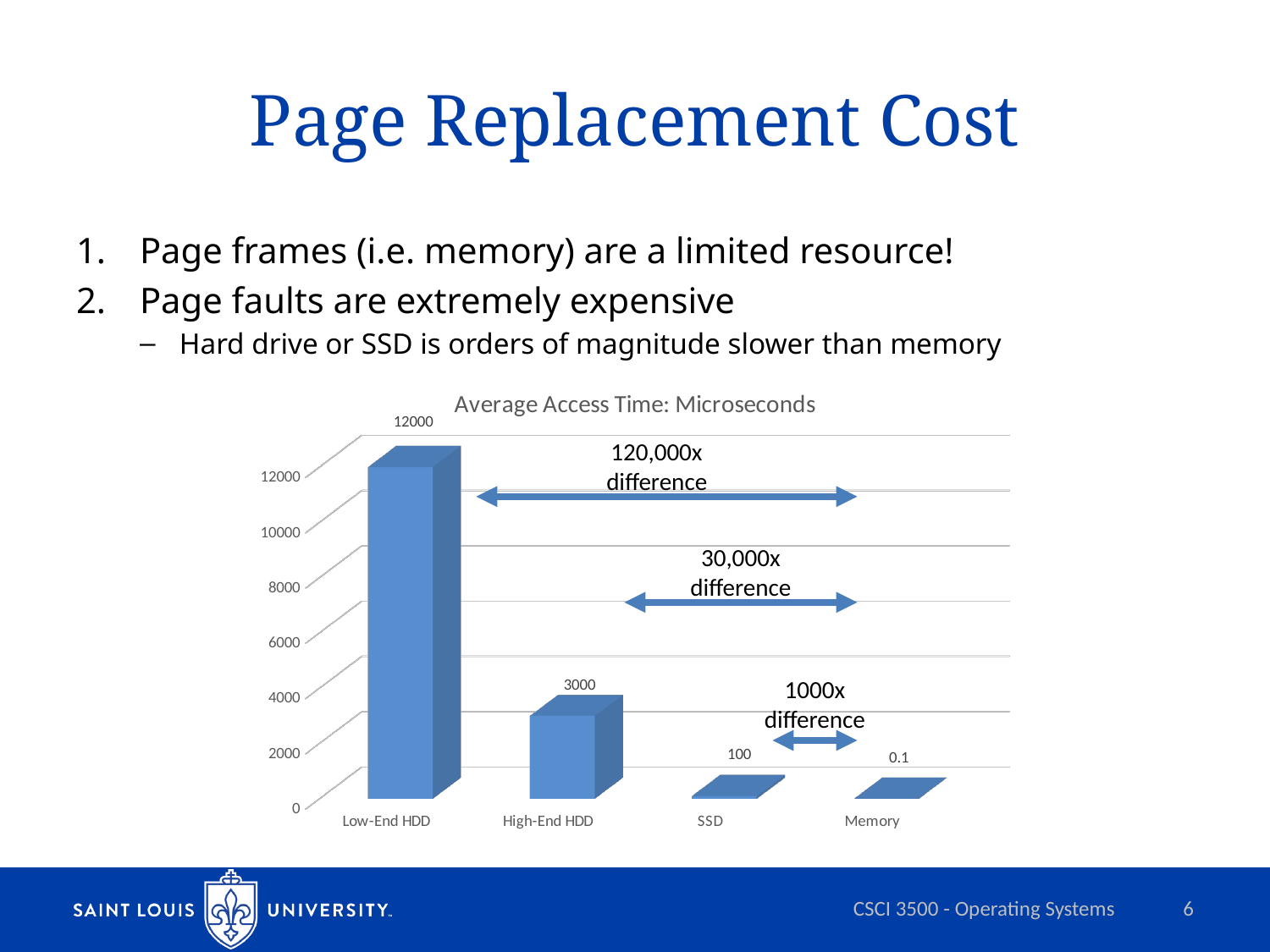
Which has a larger average access time, High-End HDD or SSD? High-End HDD What is the average access time for SSD? 100 Which category has the highest average access time? Low-End HDD What is the average access time for High-End HDD? 3000 Which category has the lowest average access time? Memory What is the title of the chart? Average Access Time: Microseconds What is the average access time for Low-End HDD? 12000 What kind of chart is shown on the slide? Bar chart How many categories are shown on the x axis of the chart? 4 Do the values rise or fall from left to right along the x axis? Fall What is the difference in average access time between Low-End HDD and High-End HDD? 9000 What is the average access time for Memory? 0.1